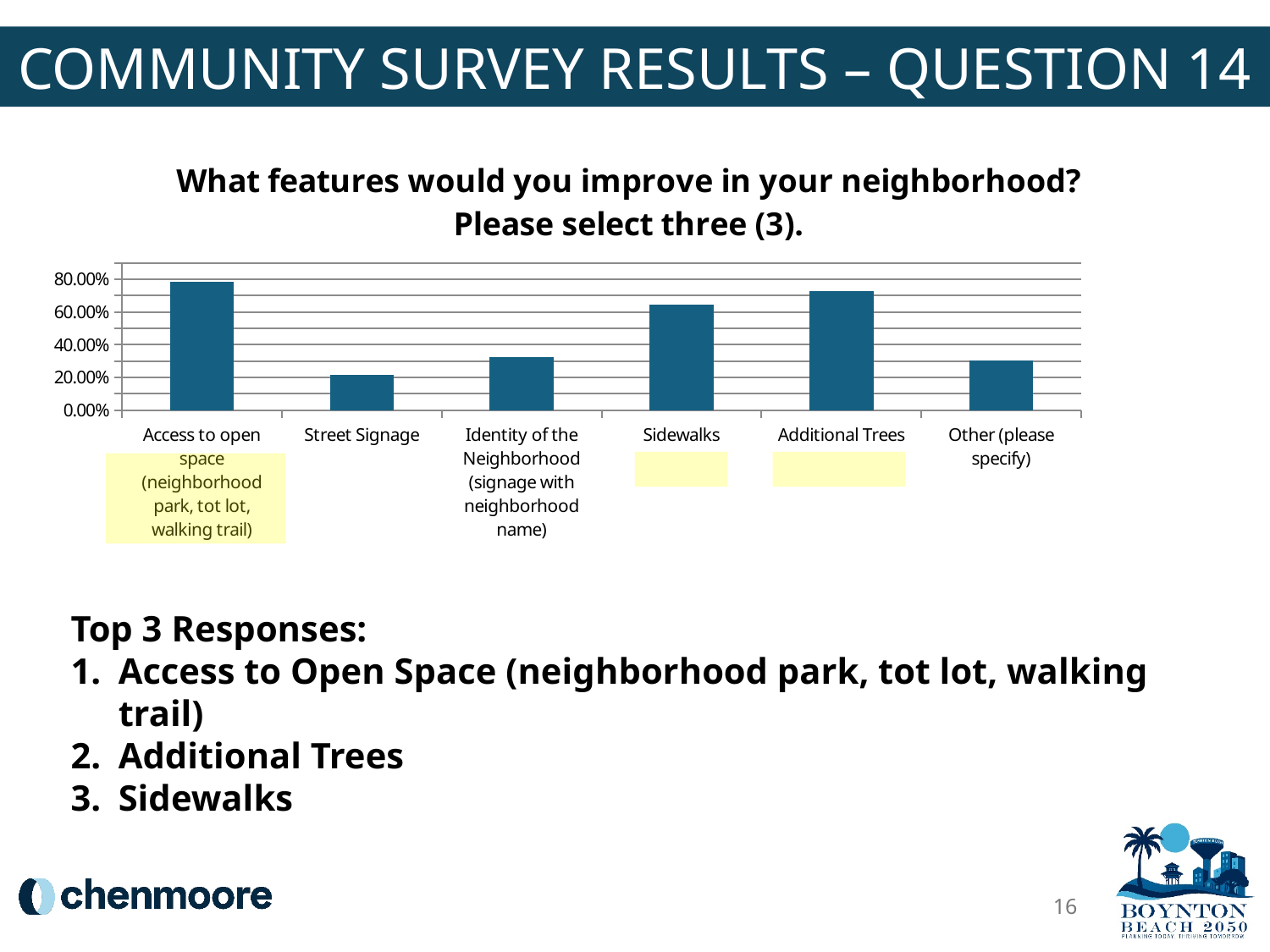
Which has a larger value, Sidewalks or Additional Trees? Additional Trees Which category has the highest value in the chart? Access to open space (neighborhood park, tot lot, walking trail) Is the value for Access to open space greater or less than 60.00%? greater What is the title of the chart? What features would you improve in your neighborhood? Please select three (3). Which has a larger value, Street Signage or Identity of the Neighborhood? Identity of the Neighborhood Is the value for Other (please specify) greater or less than 40.00%? less How many categories are plotted in the chart? 6 Is the value for Additional Trees greater or less than 60.00%? greater Which category has the lowest value in the chart? Street Signage What kind of chart is shown on the slide? bar chart